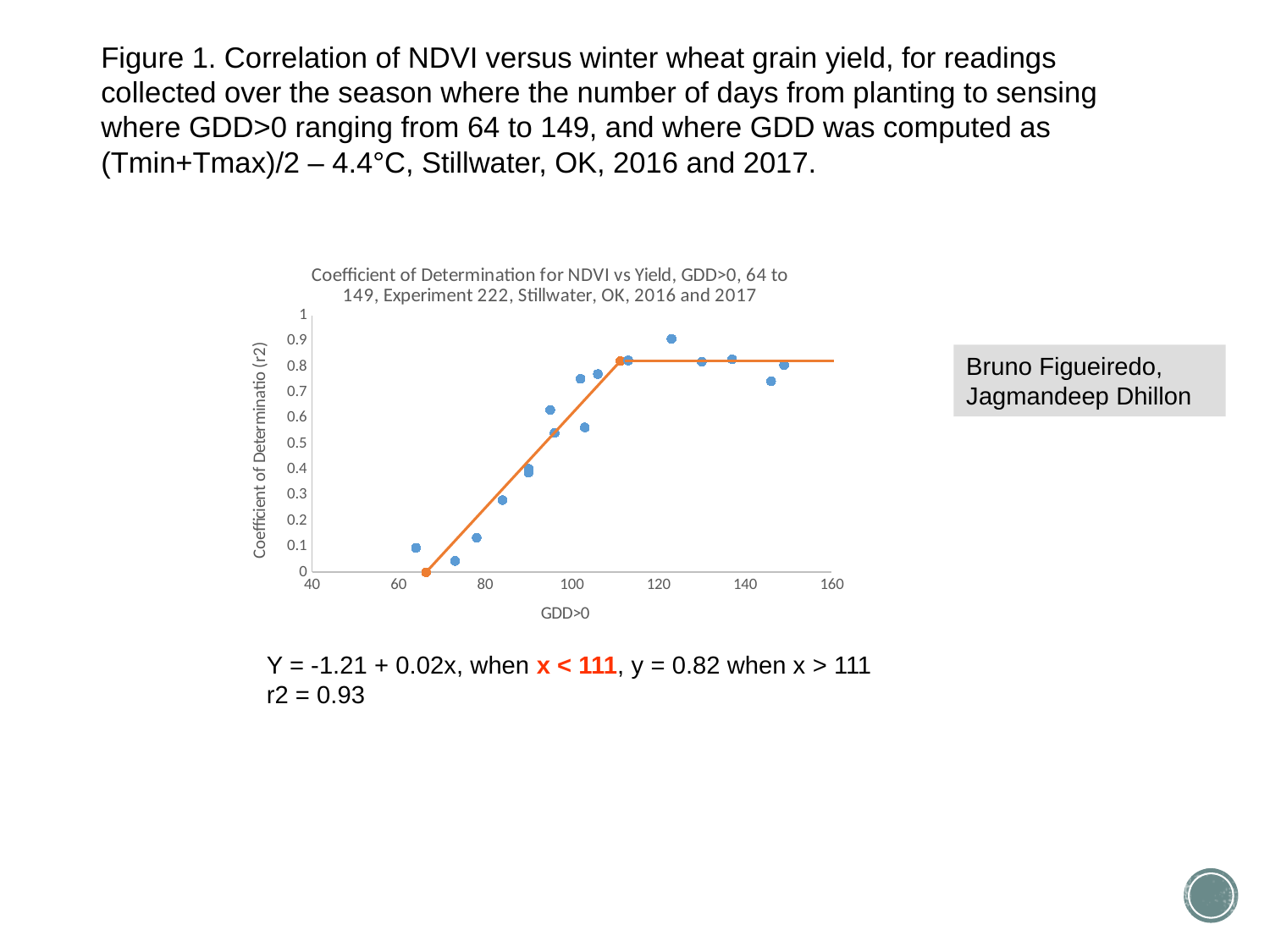
How does the coefficient of determination change as GDD>0 increases from 60 to 110? It rises What kind of chart is shown on the slide? Scatter chart What is the label of the x axis of the chart? GDD>0 Which is larger: the coefficient of determination at GDD>0 of about 73 or at GDD>0 of about 122? GDD>0 of about 122 What r2 value is reported for the fitted relationship below the chart? 0.93 What is the title of the chart? Coefficient of Determination for NDVI vs Yield, GDD>0, 64 to 149, Experiment 222, Stillwater, OK, 2016 and 2017 According to the fitted equation shown below the chart, what is the value of y when x > 111? 0.82 Is the plotted point near GDD>0 of about 137 greater or less than 0.5 on the y axis? greater Is the plotted point near GDD>0 of about 84 greater or less than 0.5 on the y axis? less Is the plotted point near GDD>0 of about 64 greater or less than 0.2 on the y axis? less What is the maximum value shown on the x axis of the chart? 160